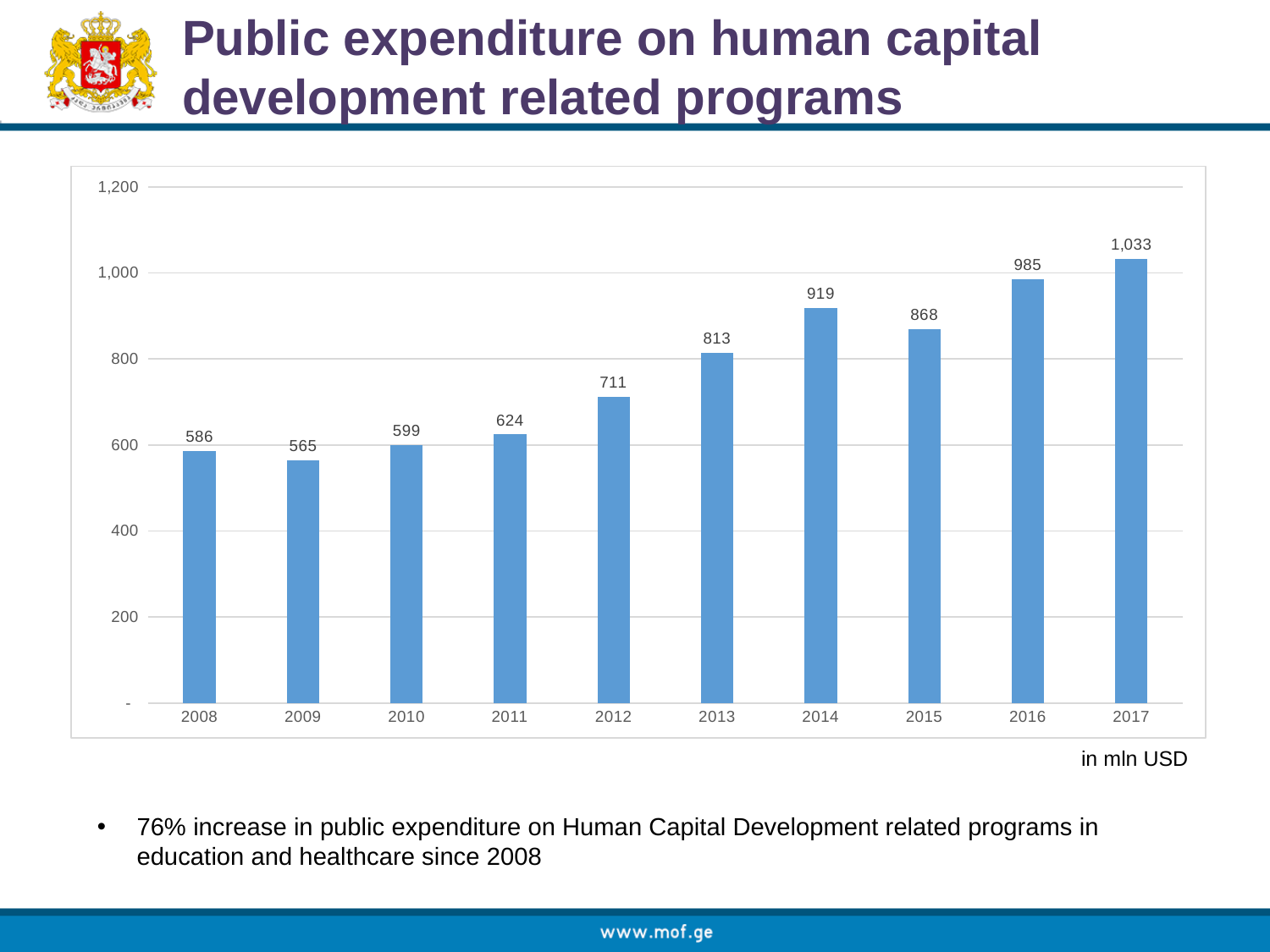
What is the difference between the values for 2014 and 2015? 51 What is the value for 2012? 711 Which year has the lowest value? 2009 What kind of chart is shown on the slide? bar chart What is the difference between the values for 2017 and 2008? 447 What unit are the values expressed in, according to the note below the chart? in mln USD How many years are shown on the x axis? 10 What is the value for 2009? 565 What is the value for 2017? 1,033 Which year has the highest value? 2017 Which is larger, the value for 2014 or the value for 2015? 2014 Is the value for 2016 greater or less than 1,000? less